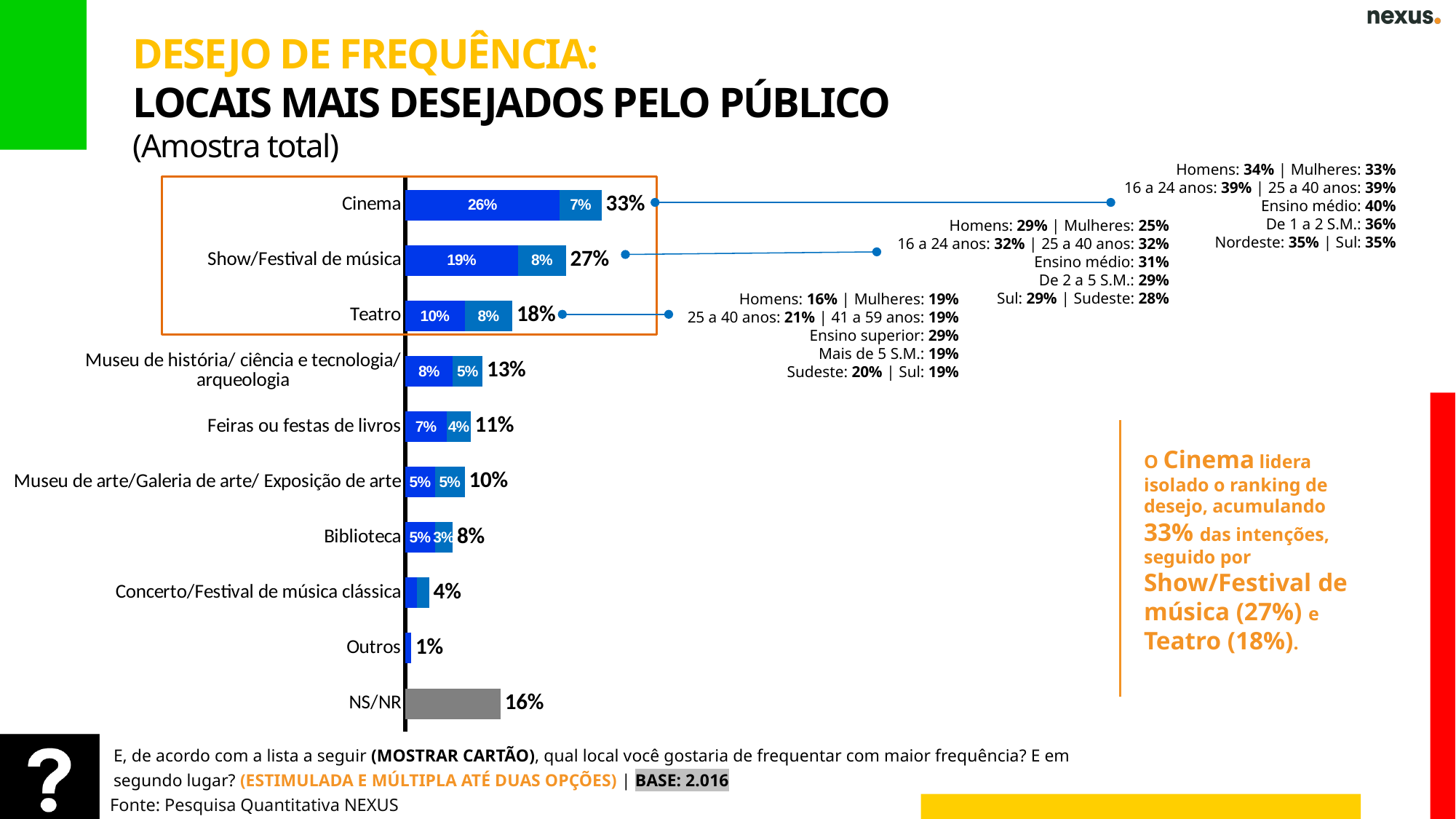
Which category has the highest total value? Cinema What is the value of the second (lighter blue) segment of the Show/Festival de música bar? 8% What is the total value shown for Show/Festival de música? 27% What is the value of the first (darker blue) segment of the Teatro bar? 10% Which has a larger total value, Feiras ou festas de livros or Museu de arte/Galeria de arte/ Exposição de arte? Feiras ou festas de livros What is the difference between the total for Cinema and the total for Teatro? 15% What is the value shown for NS/NR? 16% Which category has the lowest total value? Outros What is the total value shown for Biblioteca? 8% How many categories are plotted in the chart? 10 What kind of chart is shown on the slide? Bar chart What is the total value shown for Cinema? 33%